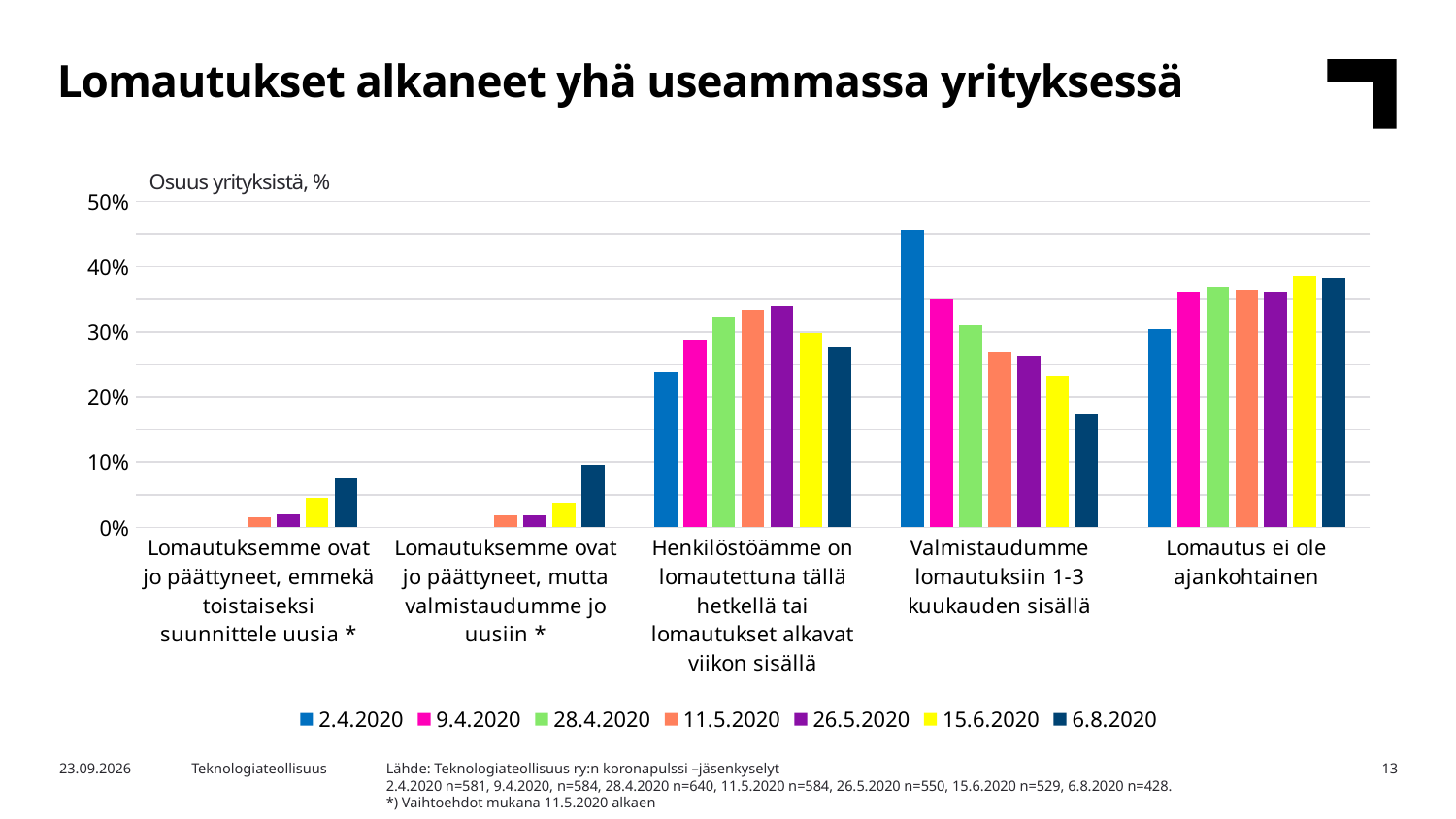
How many categories are shown on the x axis? 5 In 'Henkilöstöämme on lomautettuna tällä hetkellä tai lomautukset alkavat viikon sisällä', which is larger: 2.4.2020 or 26.5.2020? 26.5.2020 What is the title of the chart on the slide? Lomautukset alkaneet yhä useammassa yrityksessä What kind of chart is shown on the slide? bar chart Is the value for 6.8.2020 in 'Valmistaudumme lomautuksiin 1-3 kuukauden sisällä' greater or less than 20%? less Which series has the lowest bar in the 'Valmistaudumme lomautuksiin 1-3 kuukauden sisällä' category? 6.8.2020 Is the value for 2.4.2020 in 'Valmistaudumme lomautuksiin 1-3 kuukauden sisällä' greater or less than 40%? greater Do the values in 'Valmistaudumme lomautuksiin 1-3 kuukauden sisällä' rise or fall from 2.4.2020 to 6.8.2020? fall In 'Lomautus ei ole ajankohtainen', which is larger: 2.4.2020 or 15.6.2020? 15.6.2020 Which series has the tallest bar in the 'Valmistaudumme lomautuksiin 1-3 kuukauden sisällä' category? 2.4.2020 How many series does the legend list? 7